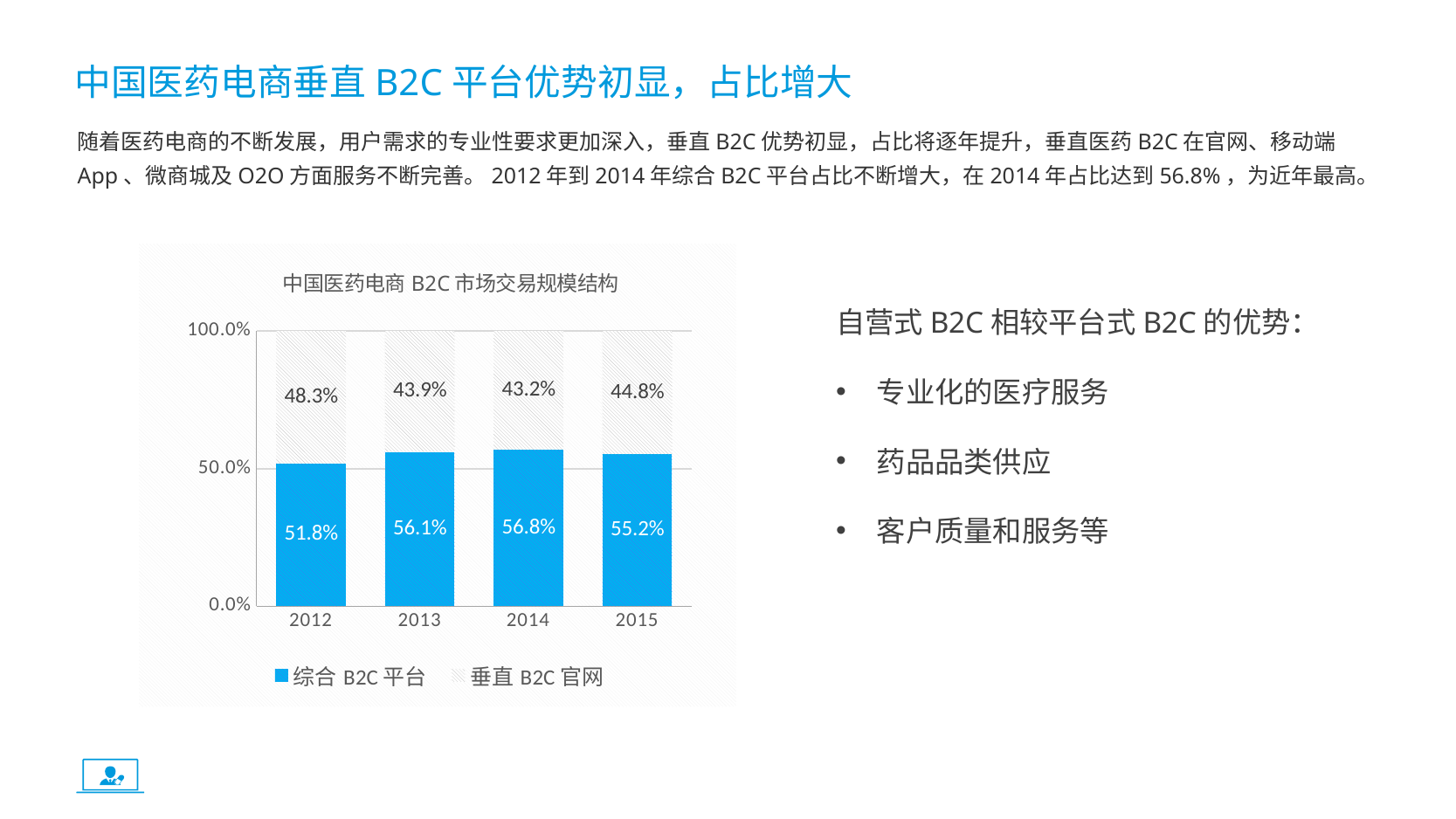
How many series does the legend list? 2 In which year is the 垂直 B2C 官网 share the lowest? 2014 Which is larger: the 垂直 B2C 官网 value in 2012 or in 2015? 2012 What is the value for 综合 B2C 平台 in 2014? 56.8% What is the difference between the 综合 B2C 平台 value in 2013 and in 2012? 4.3% What is the title of the chart? 中国医药电商 B2C 市场交易规模结构 How many years are shown on the x axis? 4 What is the value for 垂直 B2C 官网 in 2012? 48.3% What is the value for 综合 B2C 平台 in 2015? 55.2% What is the total of the stacked bar for 2013? 100.0% What kind of chart is shown on the slide? Stacked bar chart In which year is the 综合 B2C 平台 share the highest? 2014